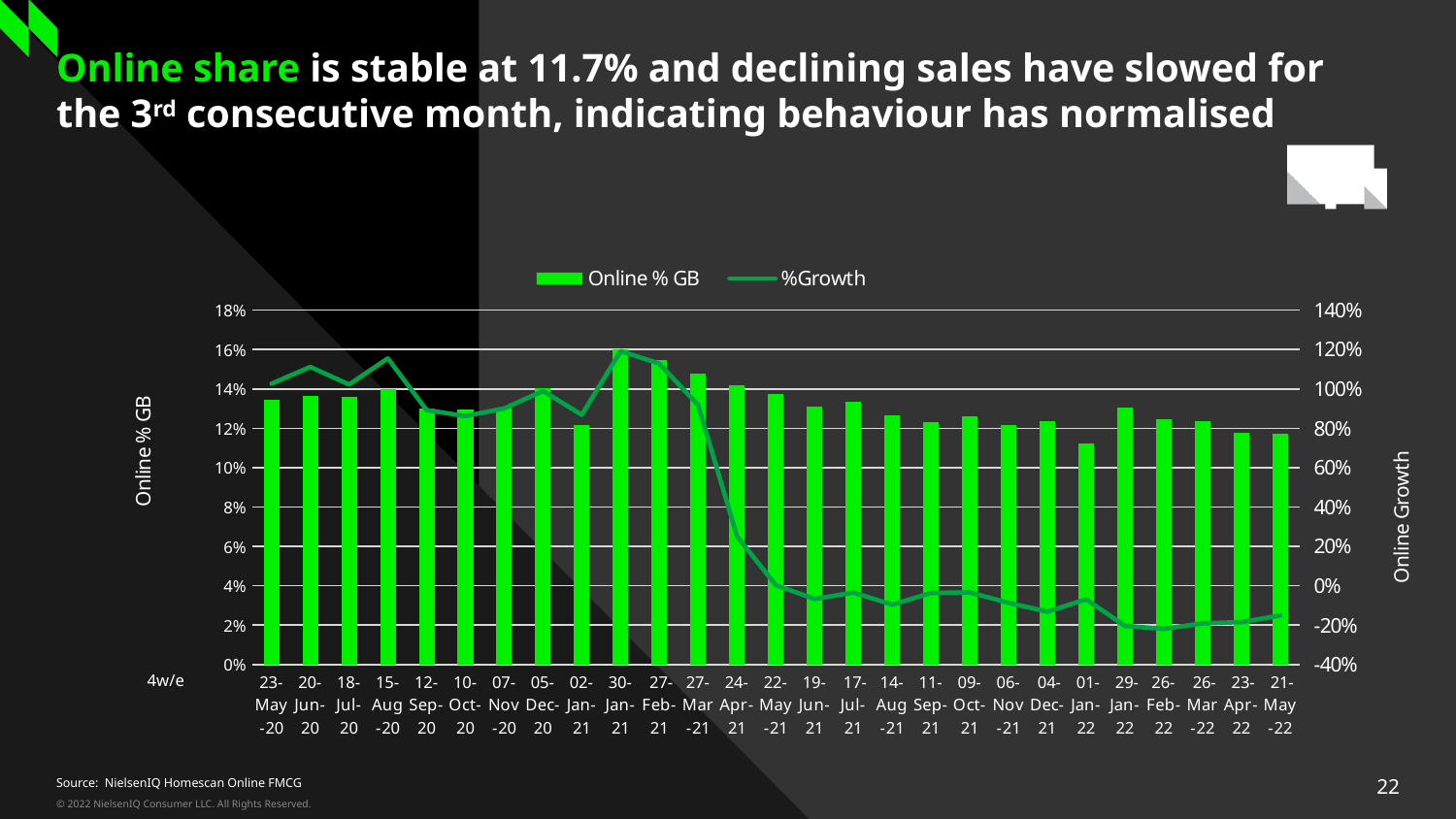
Which has the larger Online % GB bar, 23-May-20 or 01-Jan-22? 23-May-20 Is the Online % GB value for 01-Jan-22 greater or less than 12%? less How many series does the chart legend list? 2 Is the %Growth value for 15-Aug-20 greater or less than 100%? greater What are the two series named in the chart legend? Online % GB and %Growth How many dated periods (4w/e) are shown along the x axis of the chart? 27 What kind of chart is shown on the slide? A combined bar and line chart Is the %Growth value for 26-Feb-22 greater or less than 0%? less Which period has the highest Online % GB bar? 30-Jan-21 Does the %Growth line generally rise or fall from 23-May-20 to 21-May-22? fall Which period has the lowest Online % GB bar? 01-Jan-22